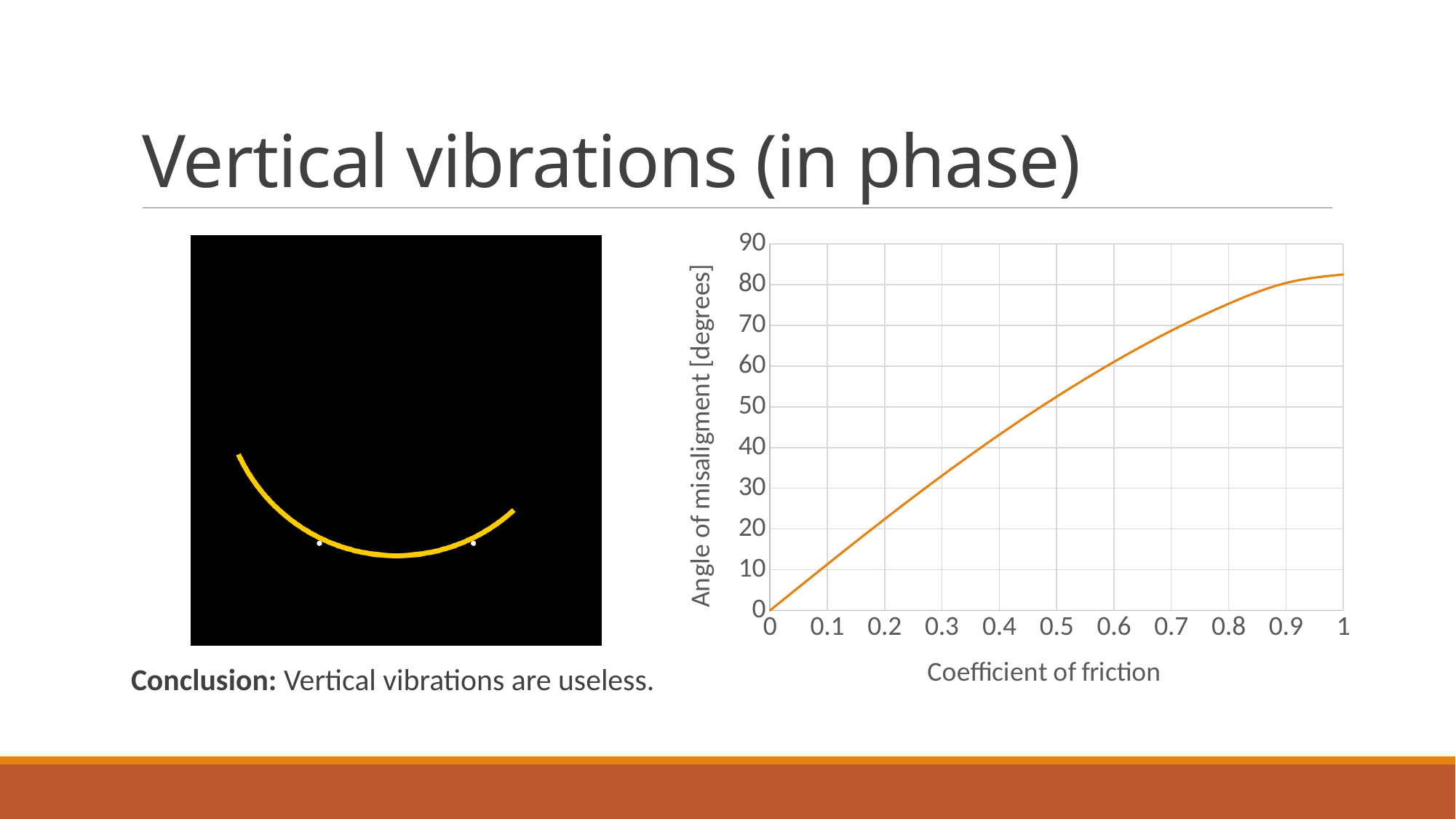
What is the label of the x axis of the chart? Coefficient of friction What is the angle of misalignment at a coefficient of friction of 0? 0 What is the label of the y axis of the chart? Angle of misaligment [degrees] Does the angle of misalignment rise or fall as the coefficient of friction increases from 0 to 1? rise At which coefficient of friction is the angle of misalignment lowest? 0 At which coefficient of friction is the angle of misalignment highest? 1 What kind of chart is shown on the slide? line chart Is the angle of misalignment at a coefficient of friction of 1 greater or less than 90? less Which is larger: the angle of misalignment at a coefficient of friction of 0.3 or at 0.7? 0.7 Is the angle of misalignment at a coefficient of friction of 0.2 greater or less than 30? less Is the angle of misalignment at a coefficient of friction of 0.8 greater or less than 60? greater